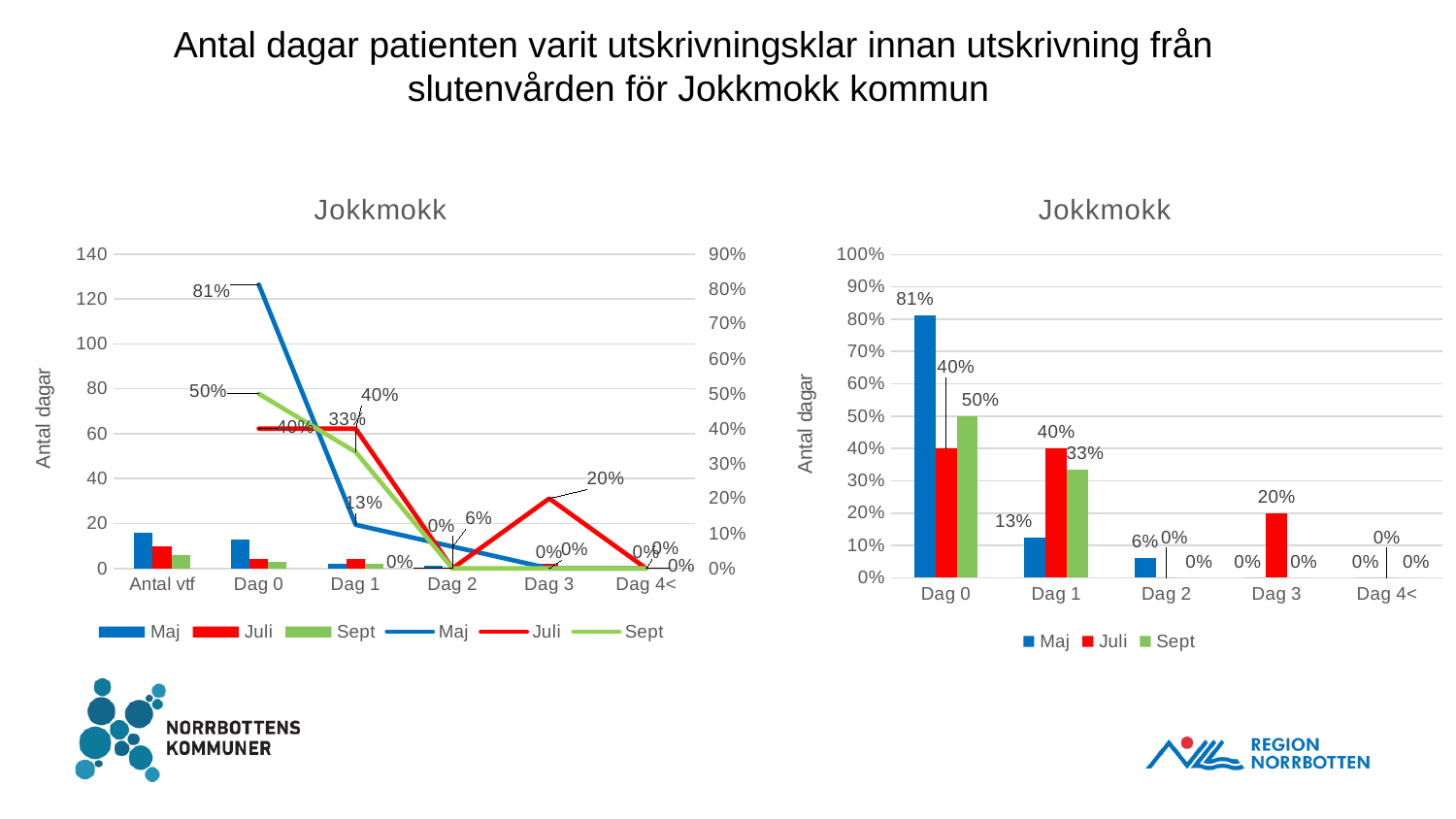
What kind of chart is the right-hand chart? Bar chart In the right-hand chart, which is larger at Dag 1: Juli or Sept? Juli In the right-hand chart, what is the value for Maj at Dag 0? 81% In the left-hand chart, does the Maj line rise or fall from Dag 0 to Dag 2? Fall How many series does the legend of the right-hand chart list? 3 In the right-hand chart, which series has the lowest value at Dag 1? Maj In the left-hand chart, is the Maj bar for Antal vtf greater or less than 10? greater In the right-hand chart, which series has the highest value at Dag 0? Maj In the right-hand chart, what is the difference between Maj and Juli at Dag 0? 41% In the right-hand chart, what is the value for Sept at Dag 1? 33% In the right-hand chart, how many day categories are shown on the x axis? 5 In the right-hand chart, what is the value for Juli at Dag 3? 20%